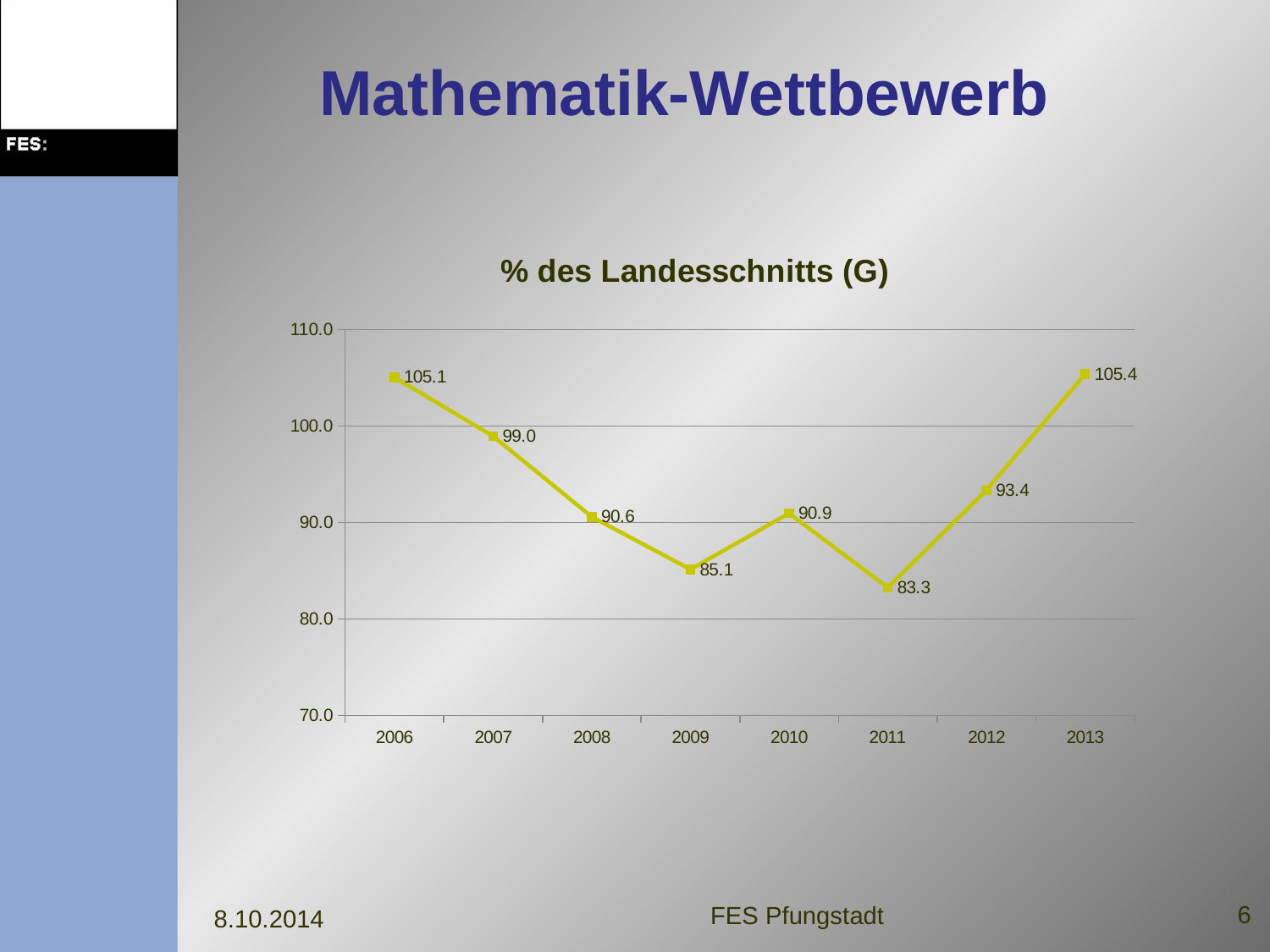
What is the difference between the values for 2006 and 2007? 6.1 Is the value for 2011 greater or less than 90.0? less Which is larger, the value for 2008 or the value for 2010? 2010 Which year has the highest value? 2013 How many years are plotted on the x axis? 8 What is the value for 2012? 93.4 Which year has the lowest value? 2011 What kind of chart is shown? line chart What is the difference between the values for 2013 and 2011? 22.1 Do the values rise or fall from 2006 to 2009? fall What is the title of the chart? % des Landesschnitts (G) What is the value for 2009? 85.1